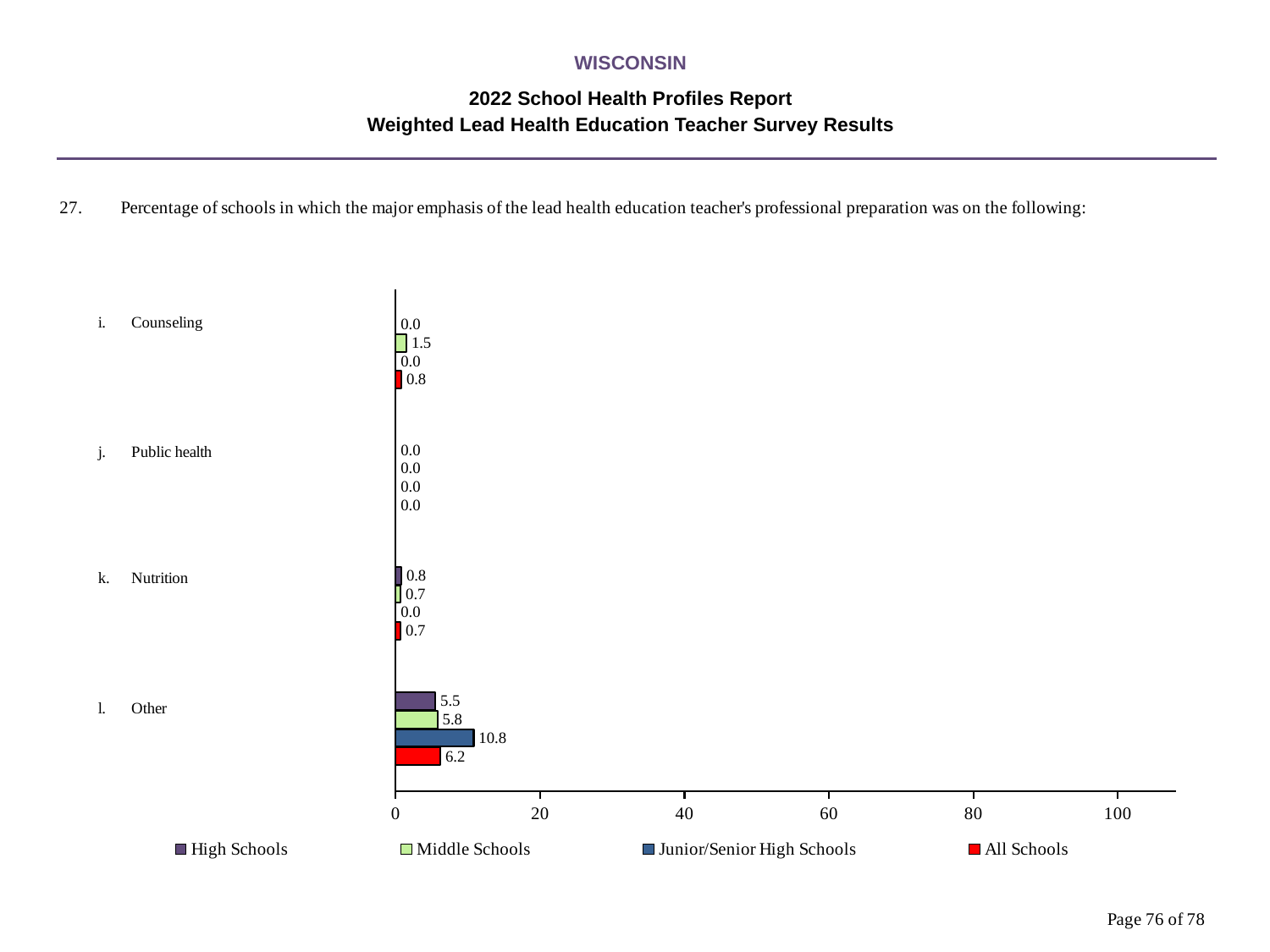
What is the value for High Schools in the Other category? 5.5 What is the value for Middle Schools in the Counseling category? 1.5 Which category has all four series at 0.0? Public health How many series does the legend list? 4 What is the value for All Schools in the Nutrition category? 0.7 Which series has the highest value in the Other category? Junior/Senior High Schools What is the value for Junior/Senior High Schools in the Other category? 10.8 What kind of chart is shown on the slide? bar chart What is the difference between the Junior/Senior High Schools and All Schools values in the Other category? 4.6 Which is larger in the Other category: the Middle Schools value or the High Schools value? Middle Schools How many categories are shown on the chart? 4 Is the value for Junior/Senior High Schools in the Other category greater or less than 20? less